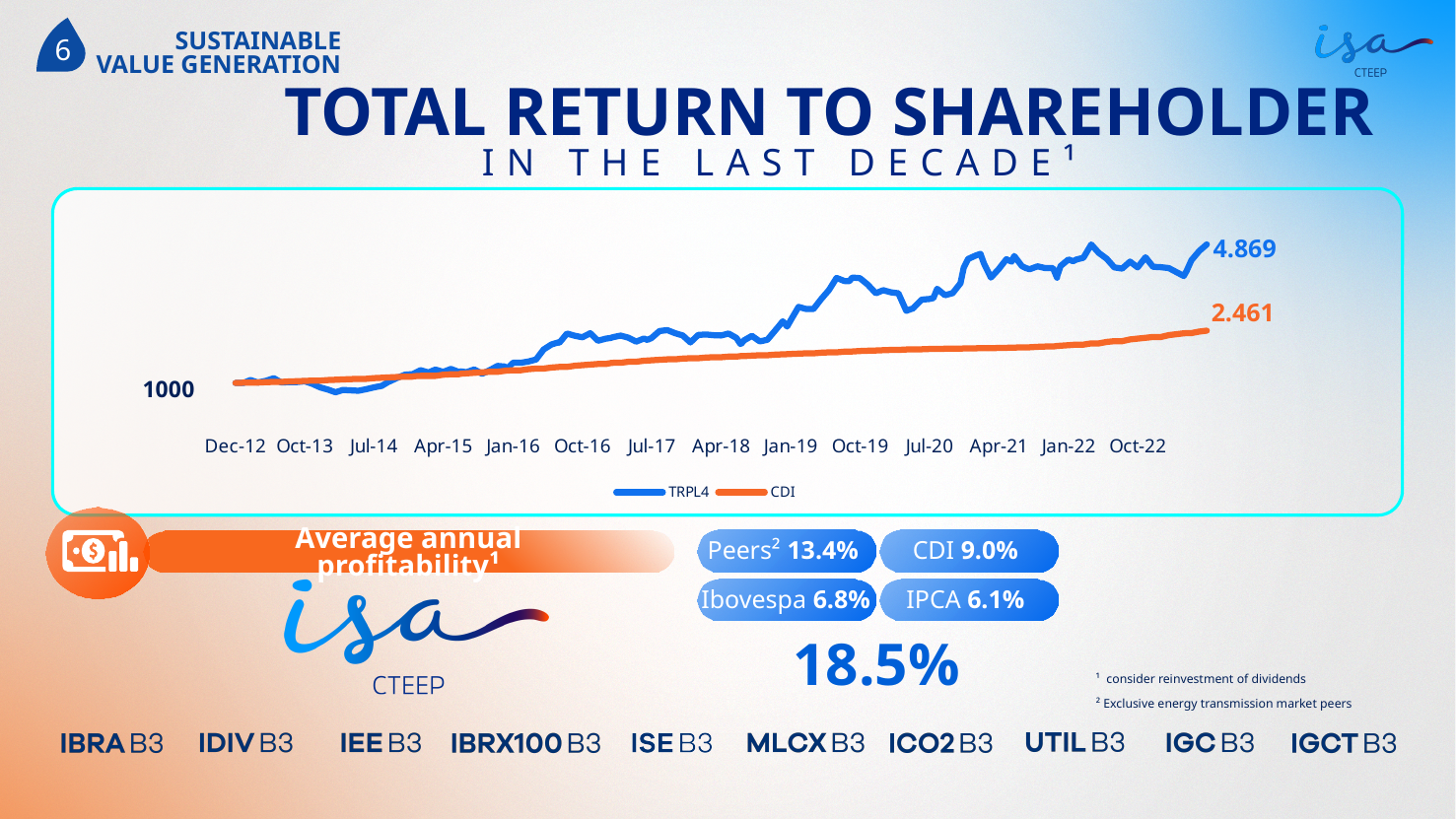
What are the two series named in the chart legend? TRPL4 and CDI Which series ends at a higher value, TRPL4 or CDI? TRPL4 What starting value is labelled at the left of the chart? 1000 What colour is the TRPL4 line on the chart? Blue What kind of chart is shown on the slide? Line chart What is the first date label on the x axis of the chart? Dec-12 What is the final value shown for the CDI series on the chart? 2.461 How many series does the chart legend list? 2 What is the final value shown for the TRPL4 series on the chart? 4.869 Does the CDI series rise or fall from Dec-12 to Oct-22? Rises How many date labels are shown along the x axis of the chart? 14 What is the difference between the final TRPL4 value and the final CDI value? 2.408